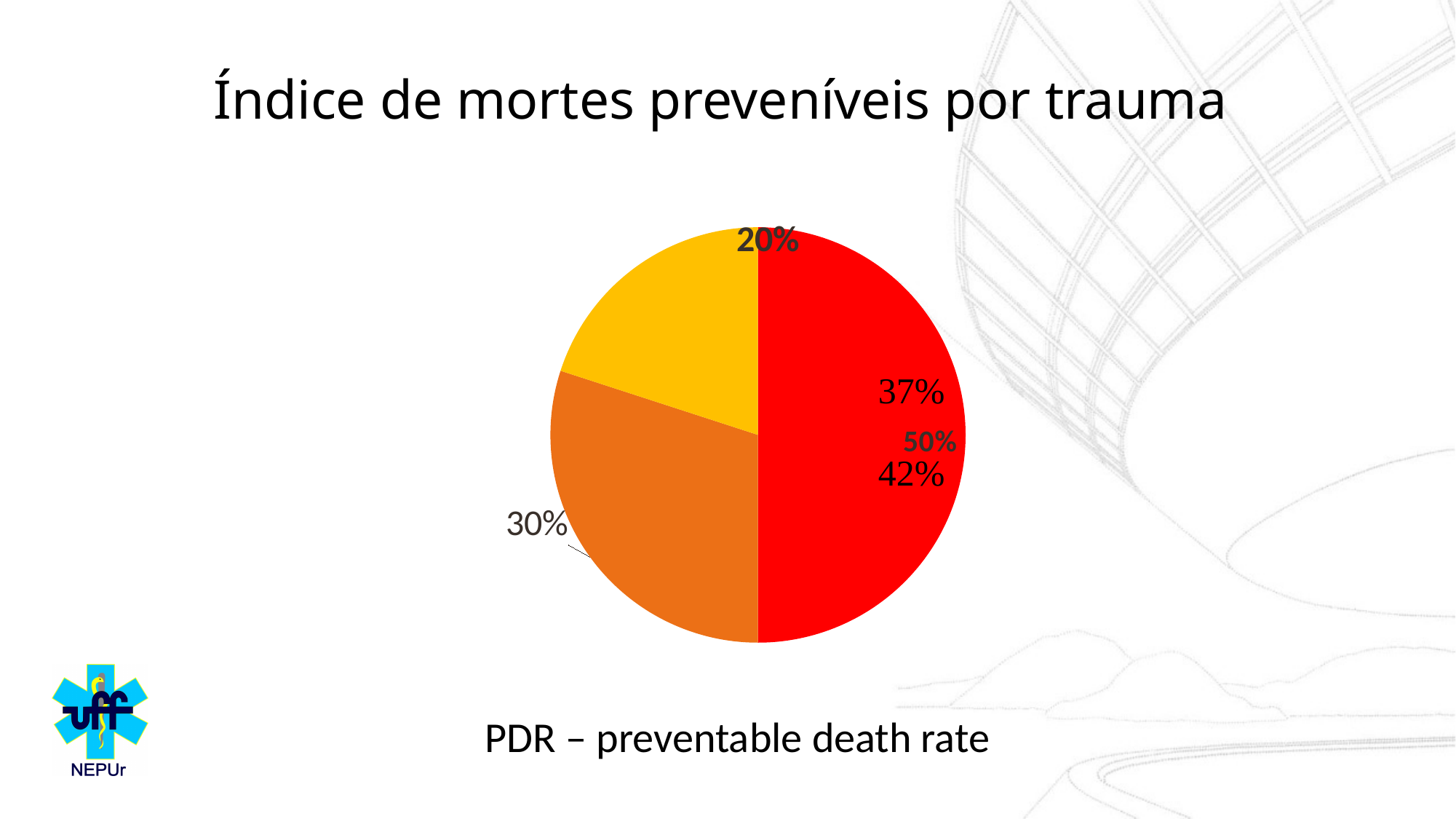
Which colour slice is the largest in the pie chart? red What is the difference in percentage points between the red slice and the orange slice? 20 Which colour slice is the smallest in the pie chart? yellow How many slices does the pie chart have? 3 What does the text below the pie chart say PDR stands for? preventable death rate What percentage is shown for the red slice of the pie chart? 50% Which is larger, the orange slice or the yellow slice? orange What kind of chart is shown on the slide? pie chart What percentage is shown for the orange slice of the pie chart? 30% What percentage is shown for the yellow slice of the pie chart? 20% What share of the pie does the red slice represent? 50% What is the title of the slide containing the pie chart? Índice de mortes preveníveis por trauma